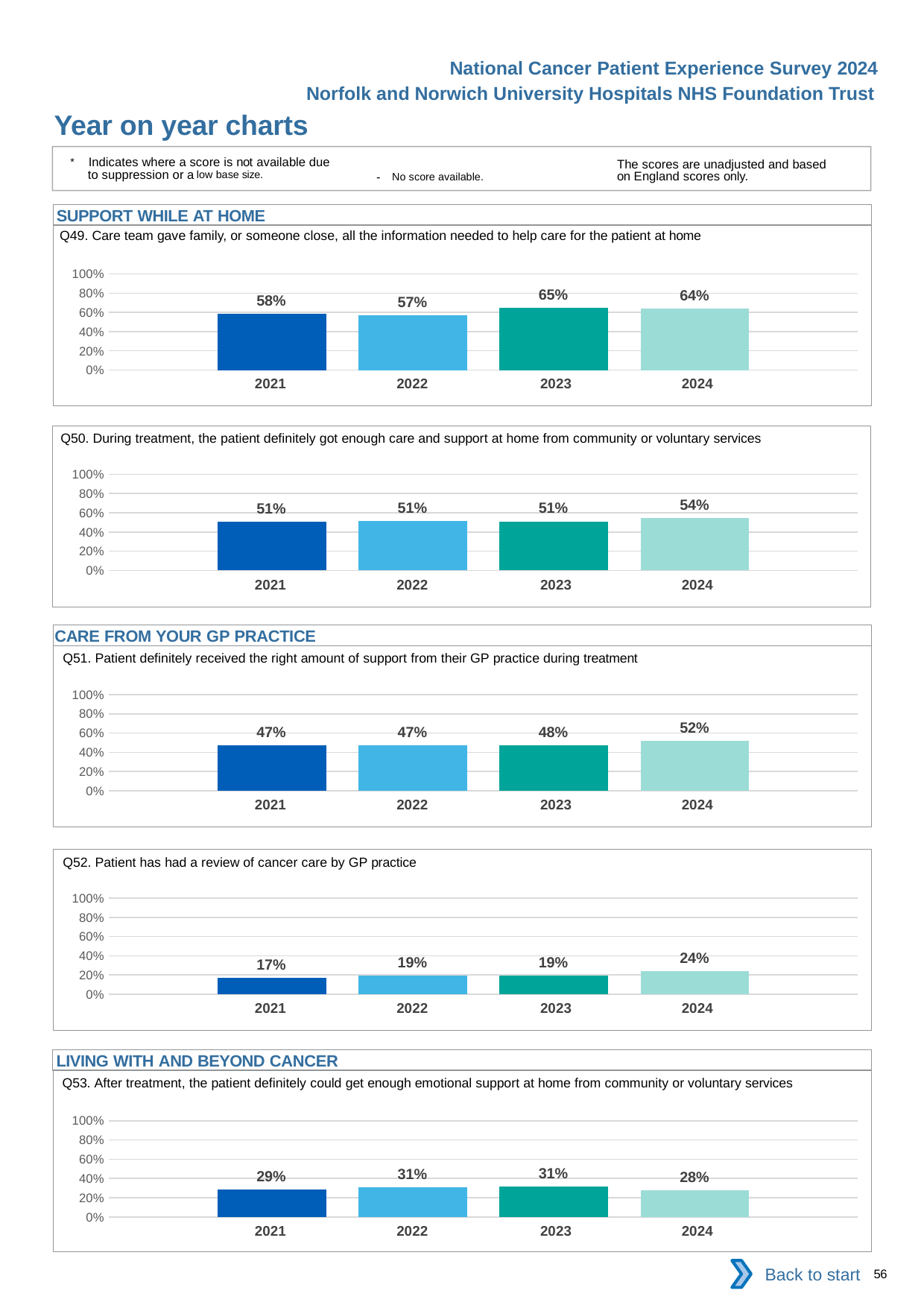
In the Q49 chart, which year has the lowest value? 2022 What kind of chart is the Q49 chart? Bar chart In the Q52 chart, what is the value for 2024? 24% In the Q53 chart, which is larger, the value for 2022 or the value for 2024? 2022 In the Q52 chart, is the value for 2021 greater or less than 20%? less In the Q51 chart, what is the value for 2021? 47% In the Q52 chart, what is the difference between the 2024 value and the 2021 value? 7% In the Q50 chart, what is the value for 2024? 54% In the Q49 chart, what is the value for 2023? 65% In the Q51 chart, which year has the highest value? 2024 In the Q53 chart, how many years are shown on the x axis? 4 In the Q50 chart, what is the difference between the 2024 value and the 2023 value? 3%